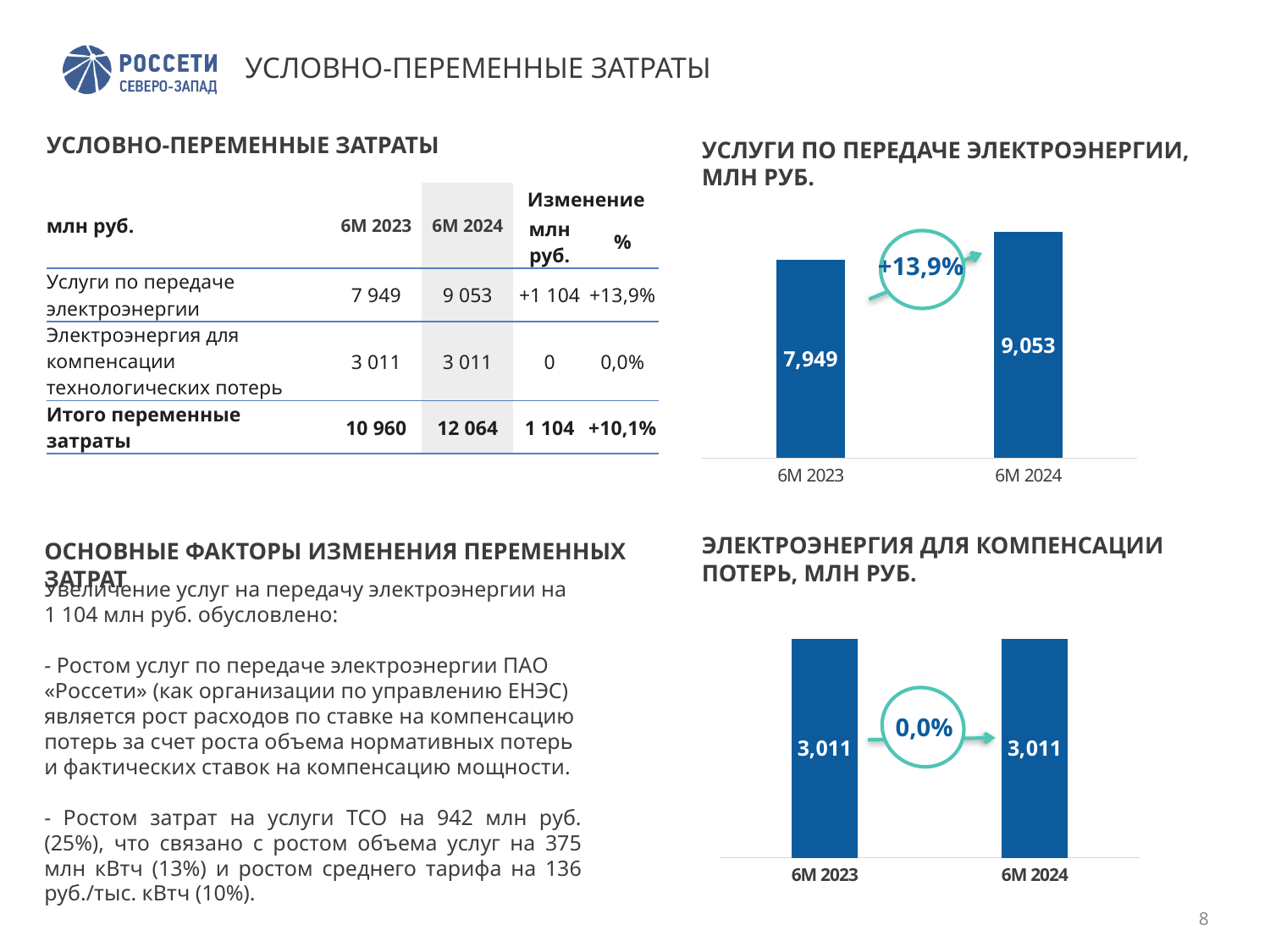
In the chart 'УСЛУГИ ПО ПЕРЕДАЧЕ ЭЛЕКТРОЭНЕРГИИ, МЛН РУБ.', which period has the higher value? 6M 2024 In the chart 'ЭЛЕКТРОЭНЕРГИЯ ДЛЯ КОМПЕНСАЦИИ ПОТЕРЬ, МЛН РУБ.', what is the value for 6M 2023? 3,011 What kind of chart is 'УСЛУГИ ПО ПЕРЕДАЧЕ ЭЛЕКТРОЭНЕРГИИ, МЛН РУБ.'? bar chart In the chart 'ЭЛЕКТРОЭНЕРГИЯ ДЛЯ КОМПЕНСАЦИИ ПОТЕРЬ, МЛН РУБ.', what percentage change is shown between 6M 2023 and 6M 2024? 0,0% In the chart 'УСЛУГИ ПО ПЕРЕДАЧЕ ЭЛЕКТРОЭНЕРГИИ, МЛН РУБ.', what is the difference between the 6M 2024 and 6M 2023 values? 1,104 In the chart 'УСЛУГИ ПО ПЕРЕДАЧЕ ЭЛЕКТРОЭНЕРГИИ, МЛН РУБ.', what is the value for 6M 2023? 7,949 In the chart 'ЭЛЕКТРОЭНЕРГИЯ ДЛЯ КОМПЕНСАЦИИ ПОТЕРЬ, МЛН РУБ.', what is the value for 6M 2024? 3,011 In the chart 'УСЛУГИ ПО ПЕРЕДАЧЕ ЭЛЕКТРОЭНЕРГИИ, МЛН РУБ.', do the values rise or fall from 6M 2023 to 6M 2024? rise In the chart 'ЭЛЕКТРОЭНЕРГИЯ ДЛЯ КОМПЕНСАЦИИ ПОТЕРЬ, МЛН РУБ.', what is the difference between the 6M 2024 and 6M 2023 values? 0 In the chart 'ЭЛЕКТРОЭНЕРГИЯ ДЛЯ КОМПЕНСАЦИИ ПОТЕРЬ, МЛН РУБ.', how many bars are plotted? 2 In the chart 'УСЛУГИ ПО ПЕРЕДАЧЕ ЭЛЕКТРОЭНЕРГИИ, МЛН РУБ.', what percentage change is shown between 6M 2023 and 6M 2024? +13,9% In the chart 'УСЛУГИ ПО ПЕРЕДАЧЕ ЭЛЕКТРОЭНЕРГИИ, МЛН РУБ.', what is the value for 6M 2024? 9,053